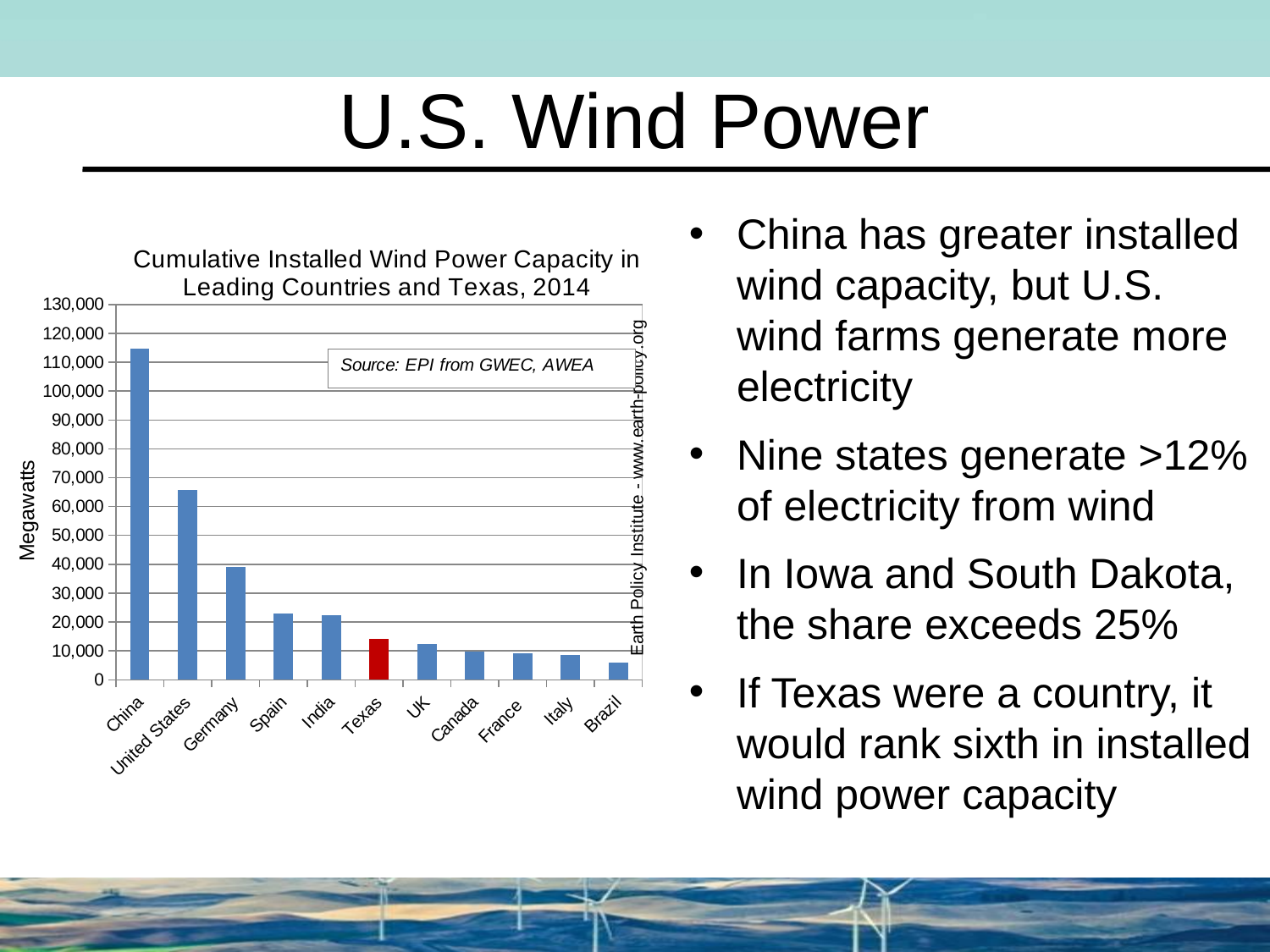
Is the value for Germany greater or less than 50,000 megawatts? less Which country has the highest cumulative installed wind power capacity in the chart? China Is the value for China greater or less than 100,000 megawatts? greater Which category has the lowest cumulative installed wind power capacity in the chart? Brazil Which bar in the chart is coloured red instead of blue? Texas Which has a larger installed wind power capacity, Germany or Spain? Germany Is the value for Texas greater or less than 10,000 megawatts? greater What kind of chart is shown on the slide? bar chart How many categories are plotted on the x axis of the chart? 11 Do the bar values rise or fall moving from left to right along the x axis? fall